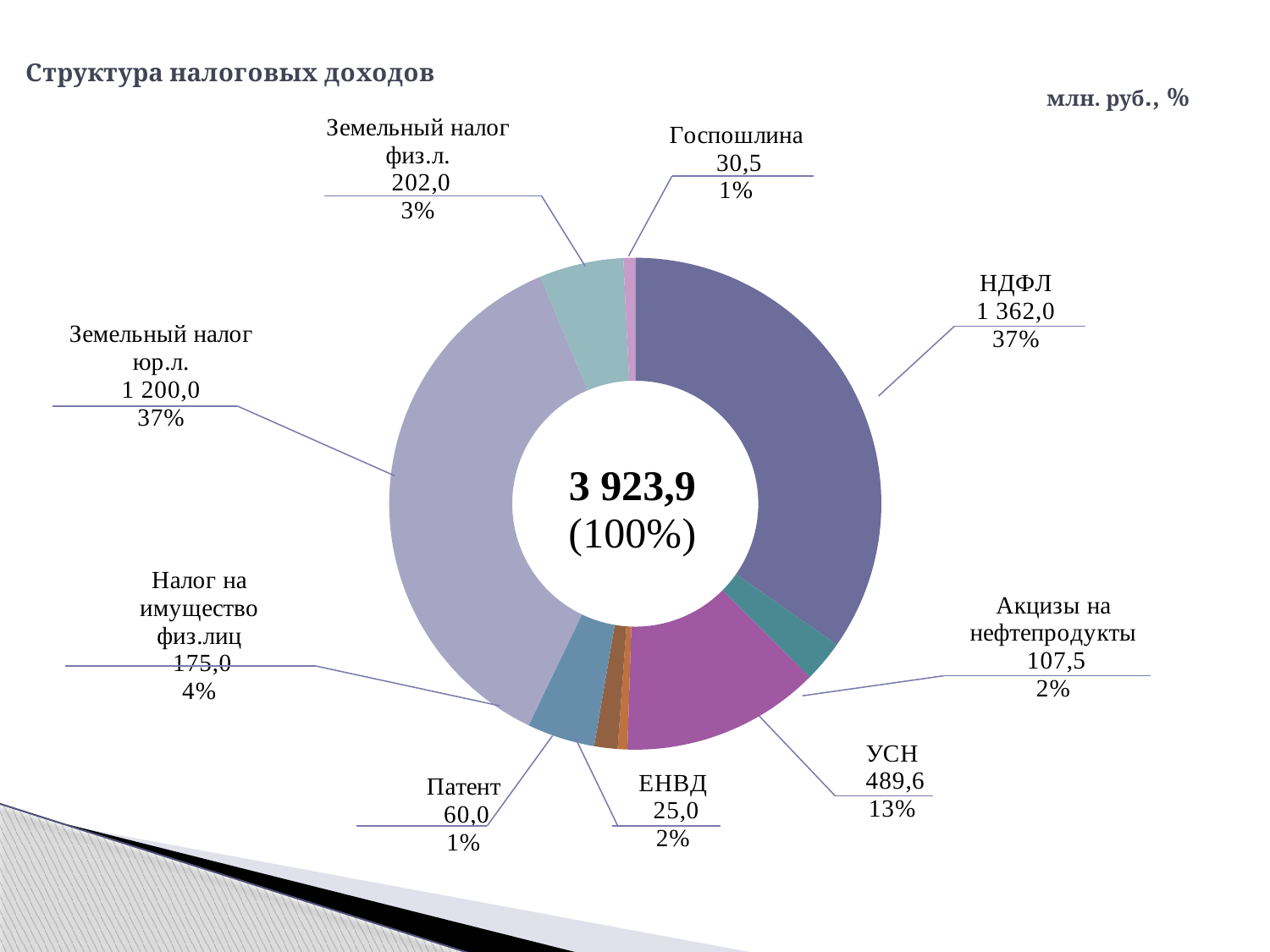
What is the value for НДФЛ? 1 362,0 How many categories does the chart show? 9 What is the value for Земельный налог юр.л.? 1 200,0 What share of the total does Налог на имущество физ.лиц represent? 4% What share of the total does УСН represent? 13% What is the difference between the values for НДФЛ and Земельный налог юр.л.? 162,0 Which category has the highest value? НДФЛ What kind of chart is shown on the slide? Pie (doughnut) chart Which category has the lowest value? ЕНВД Which is larger, the value for Земельный налог физ.л. or the value for Налог на имущество физ.лиц? Земельный налог физ.л. What is the value for Госпошлина? 30,5 What is the value for УСН? 489,6